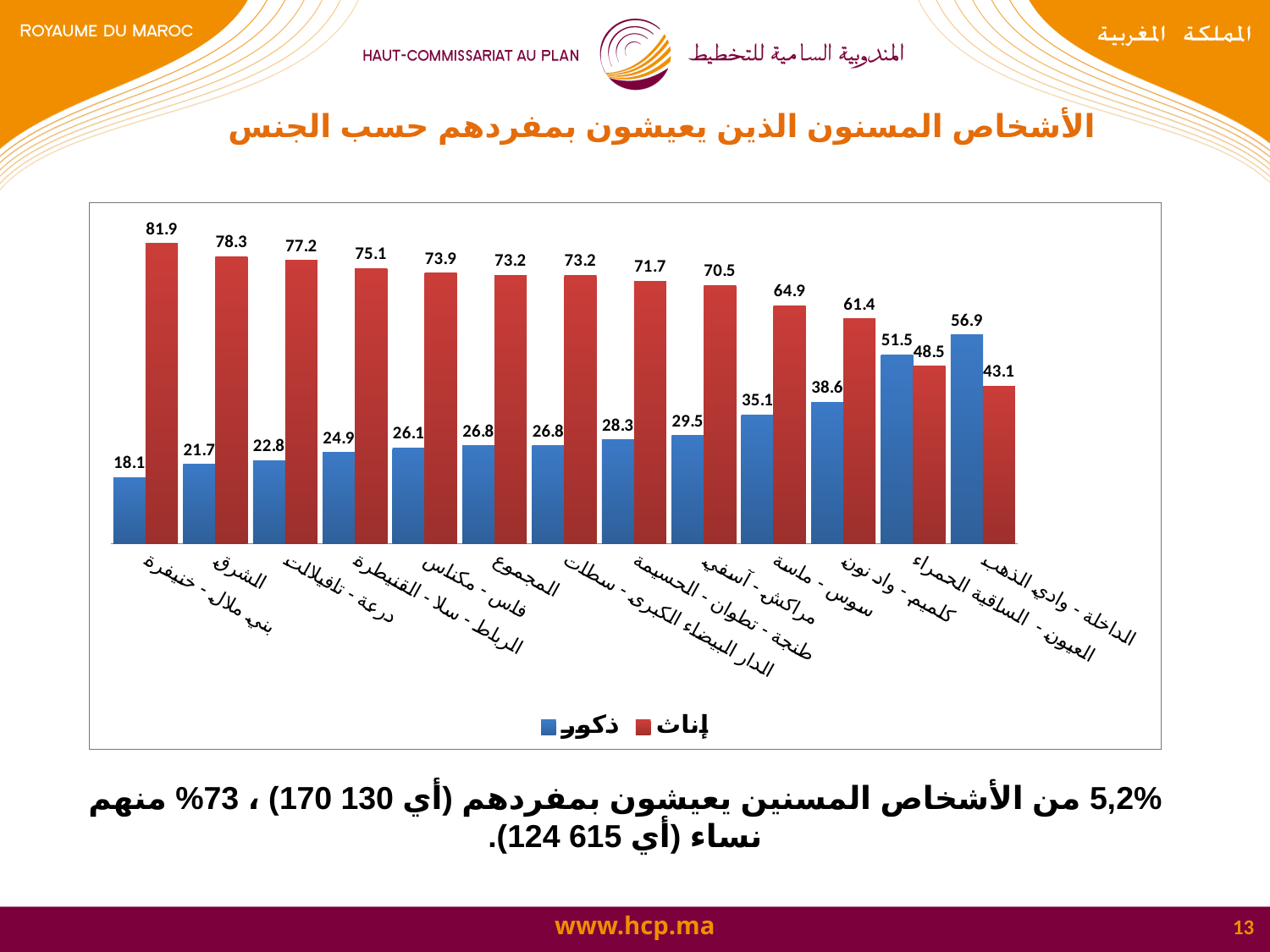
What is the difference between the إناث and ذكور values in الشرق? 56.6 What is the value for ذكور in المجموع? 26.8 What is the value for إناث in بني ملال - خنيفرة? 81.9 What is the value for ذكور in الداخلة - وادي الذهب? 56.9 How many regions (categories) are shown on the x axis? 13 Which region has the lowest value for ذكور? بني ملال - خنيفرة What is the value for إناث in سوس - ماسة? 64.9 Which region has the highest value for إناث? بني ملال - خنيفرة What type of chart is shown on the slide? bar chart How many series does the legend list? 2 Do the ذكور values rise or fall from left to right along the x axis? rise In العيون - الساقية الحمراء, which is larger, the value for ذكور or for إناث? ذكور